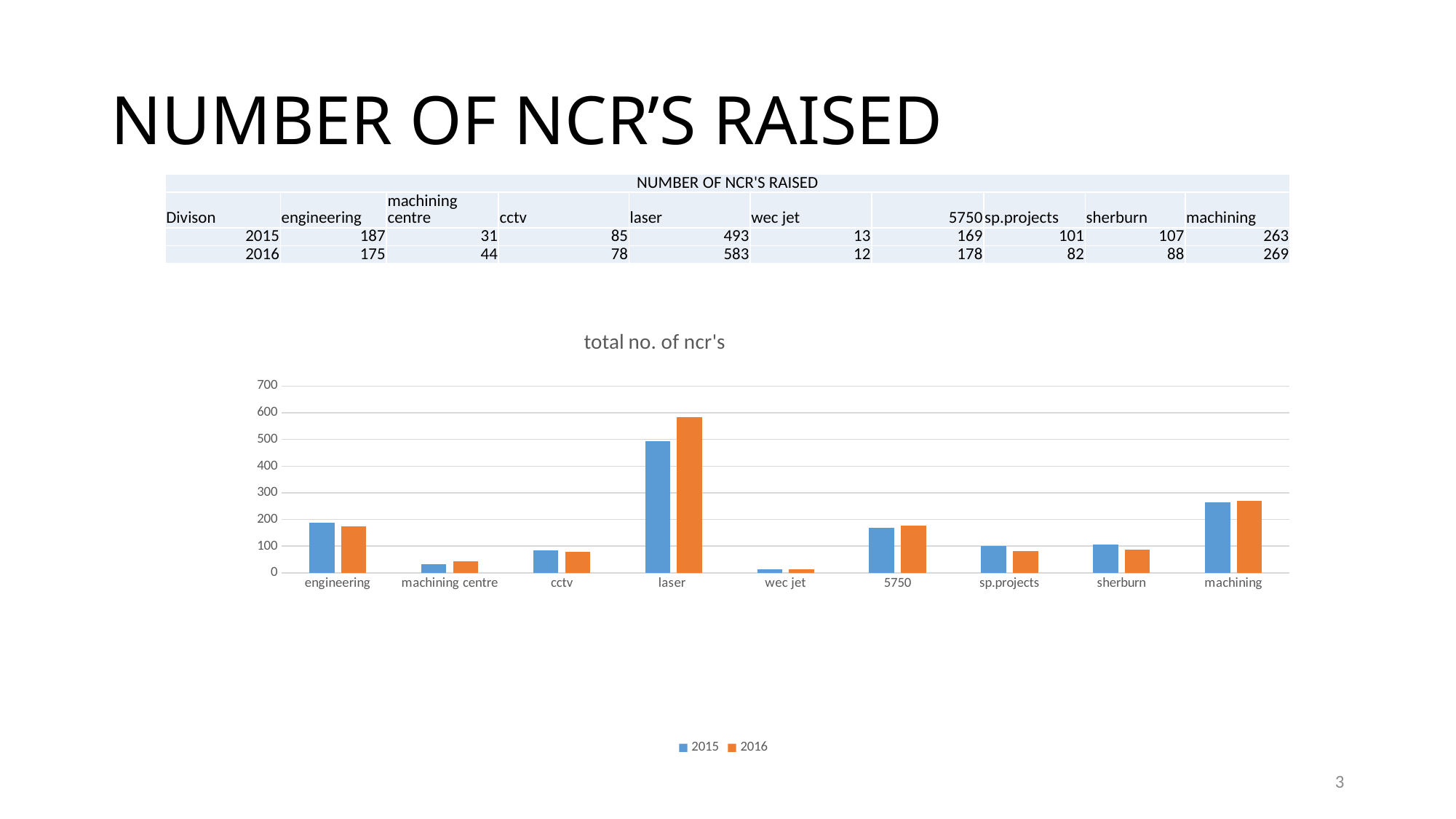
Is the 2016 value for machining greater or less than 200? greater What is the number of NCR's raised for laser in 2016? 583 What is the number of NCR's raised for machining centre in 2016? 44 Which is larger for sherburn, the 2015 value or the 2016 value? 2015 Which division has the lowest number of NCR's raised in 2016? wec jet How many series does the chart legend list? 2 What is the number of NCR's raised for engineering in 2015? 187 What is the difference between the 2016 and 2015 values for laser? 90 How many divisions are shown along the x axis of the chart? 9 What type of chart is shown on the slide? bar chart What is the title of the chart? total no. of ncr's Which division has the highest number of NCR's raised in 2015? laser